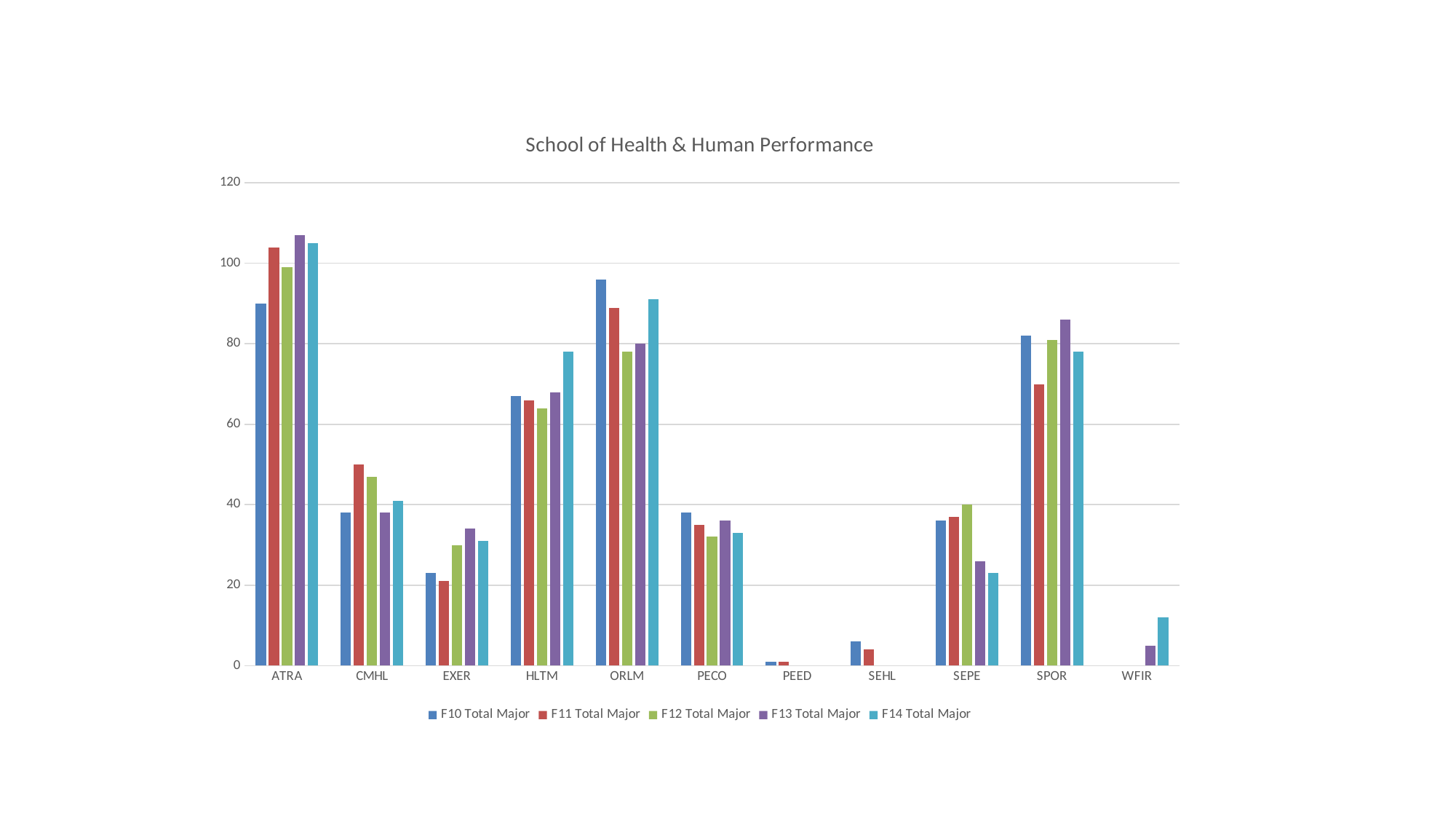
Is the F10 Total Major value for ORLM greater or less than 80? greater Which category has the tallest bars overall? ATRA Which series has the highest value for ORLM? F10 Total Major Is the F11 Total Major value for EXER greater or less than 40? less For SEPE, do the values rise or fall from F12 Total Major to F14 Total Major? fall Is the F14 Total Major value for WFIR greater or less than 20? less Which is larger for SPOR: the F10 Total Major value or the F11 Total Major value? F10 Total Major How many series does the legend list? 5 Which category has the lowest values overall? PEED How many categories are shown on the x axis? 11 What is the title of the chart? School of Health & Human Performance What type of chart is shown on the slide? bar chart